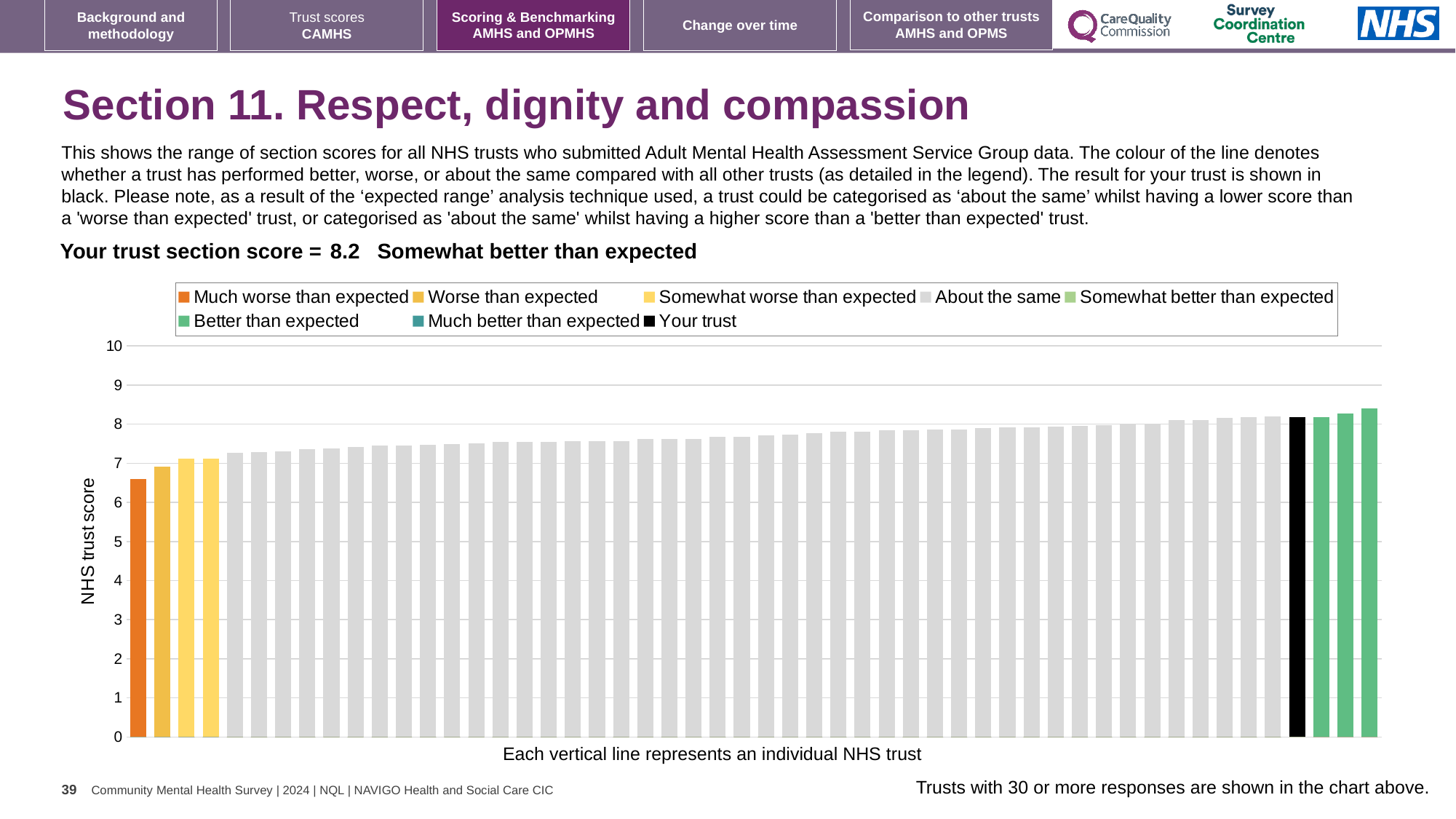
What is the label on the vertical axis of the chart? NHS trust score Is the value of the black 'Your trust' bar greater or less than 8? greater What colour is used for the 'Your trust' bar in the chart? black Do the bar values rise or fall from left to right across the chart? rise Is the value of the leftmost (orange) bar greater or less than 7? less How many orange ('Much worse than expected') bars are in the chart? 1 How many green bars appear to the right of the black 'Your trust' bar? 3 What kind of chart is shown on the slide? bar chart Is the value of the rightmost bar greater or less than 8? greater How many entries does the chart legend list? 8 What is the section score for your trust shown on the slide? 8.2 Which is taller: the black 'Your trust' bar or the leftmost orange bar? the black 'Your trust' bar